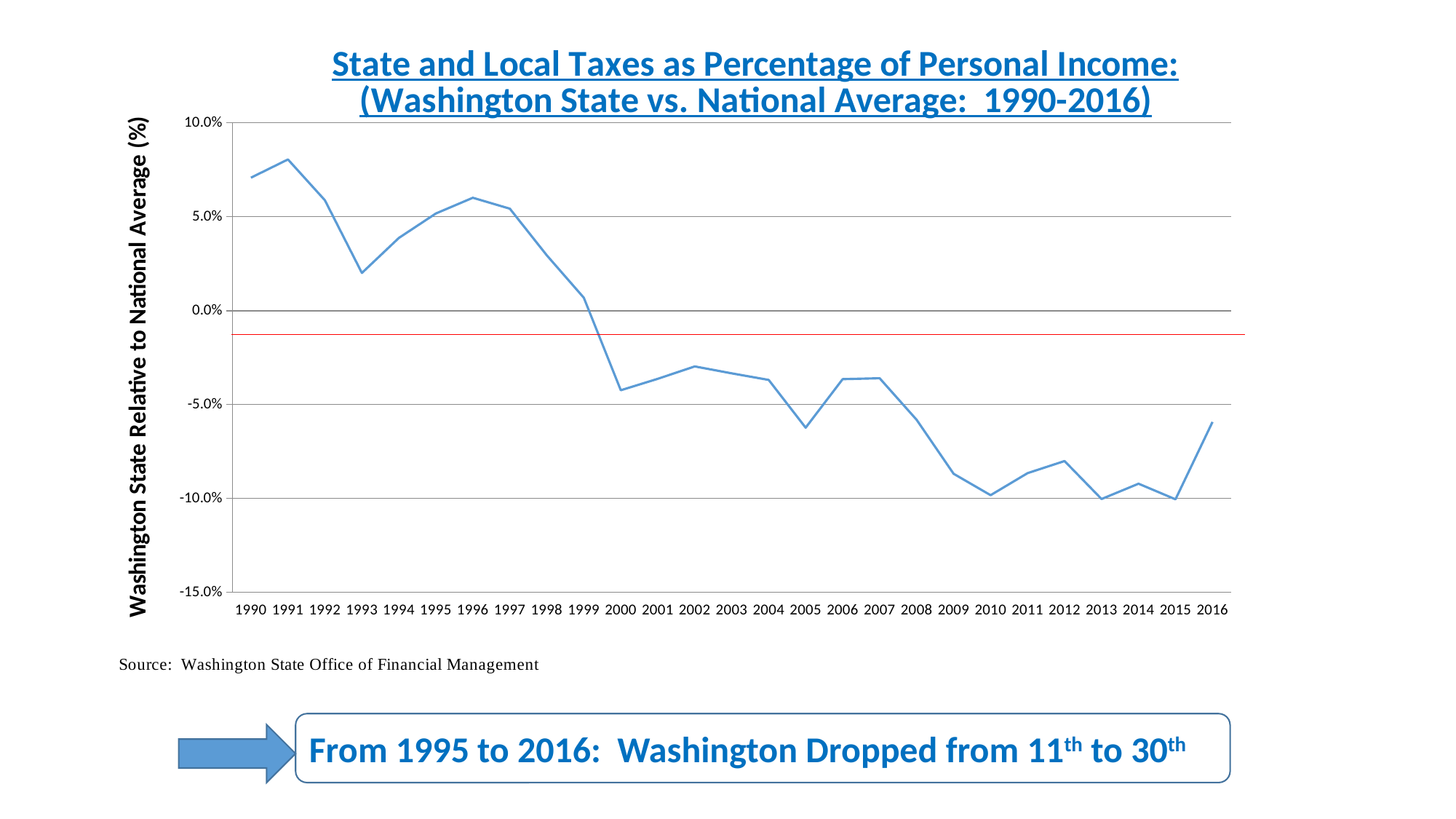
Is the value for 2010 greater or less than -5.0%? less What is the label on the vertical axis of the chart? Washington State Relative to National Average (%) Is the value for 1990 greater or less than 5.0%? greater Overall, do the values rise or fall from 1990 to 2016? fall Which year has the larger value, 2002 or 2010? 2002 How many years are plotted along the x axis? 27 Is the value for 2016 greater or less than -10.0%? greater Which year has the larger value, 1996 or 1993? 1996 Which year has the highest value on the chart? 1991 What kind of chart is shown on the slide? line chart